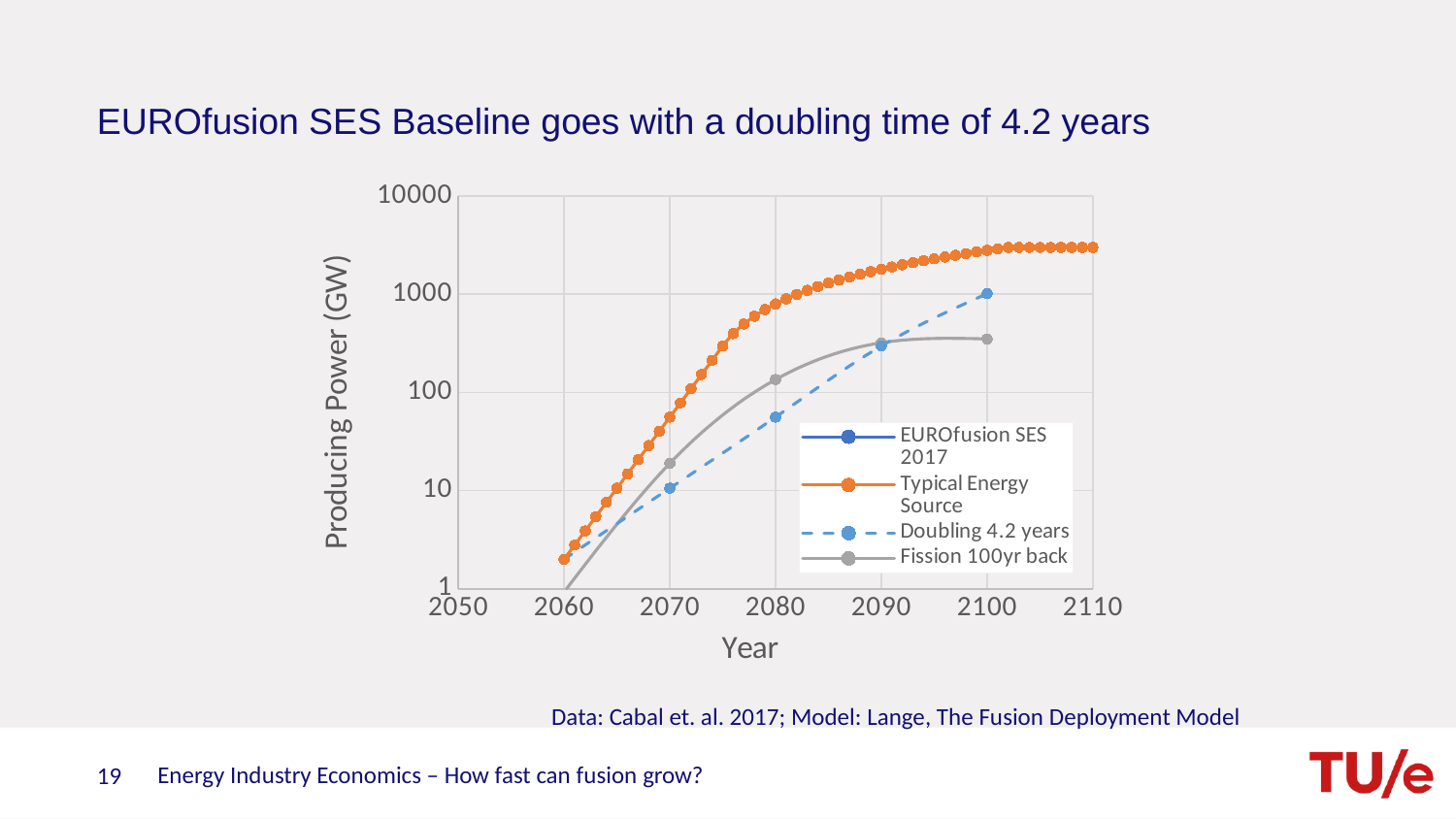
What kind of chart is shown on the slide? line chart Which series reaches the highest producing power on the chart? Typical Energy Source Is the value of the Fission 100yr back series in 2100 greater or less than 1000? less Is the value of the Typical Energy Source series in 2110 greater or less than 1000? greater How many series does the legend list? 4 Is the value of the Typical Energy Source series in 2080 greater or less than 100? greater Does the Typical Energy Source series rise or fall as the year increases? rise What is the label of the x axis? Year What is the label of the y axis? Producing Power (GW) In 2080, which series has the higher value: Typical Energy Source or Fission 100yr back? Typical Energy Source In 2100, which series has the higher value: Doubling 4.2 years or Fission 100yr back? Doubling 4.2 years